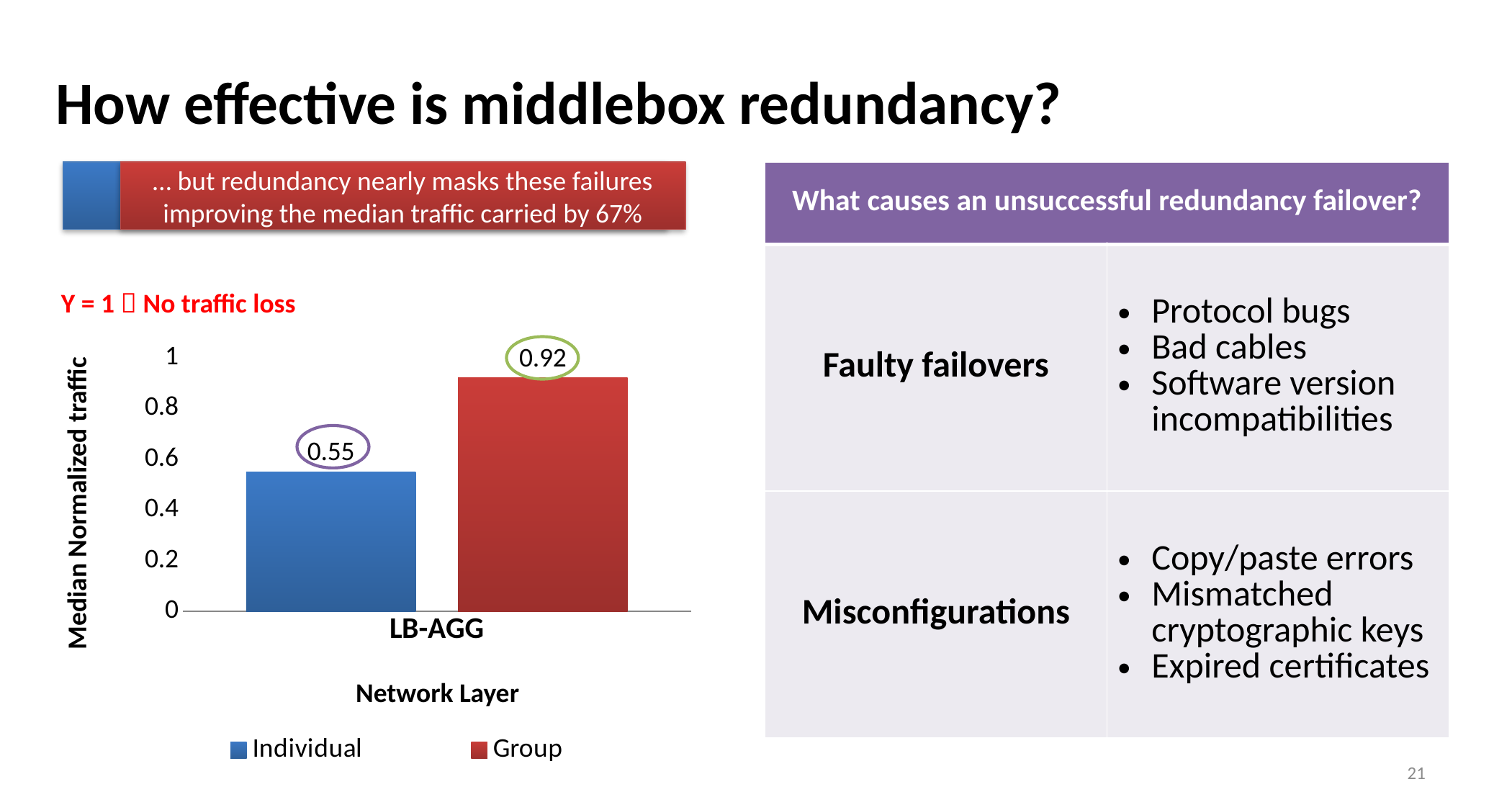
Which series has the higher median normalized traffic at LB-AGG, Individual or Group? Group Is the Individual value at LB-AGG greater or less than 0.6? less How many series does the chart legend list? 2 What is the difference between the Group and Individual values at LB-AGG? 0.37 What is the label of the x axis of the chart? Network Layer Is the Group value at LB-AGG greater or less than 0.8? greater What kind of chart is shown on the slide? Bar chart What is the median normalized traffic for the Individual series at LB-AGG? 0.55 What is the label of the y axis of the chart? Median Normalized traffic What is the median normalized traffic for the Group series at LB-AGG? 0.92 How many categories are shown on the x axis of the chart? 1 Which series has the lowest value in the chart? Individual